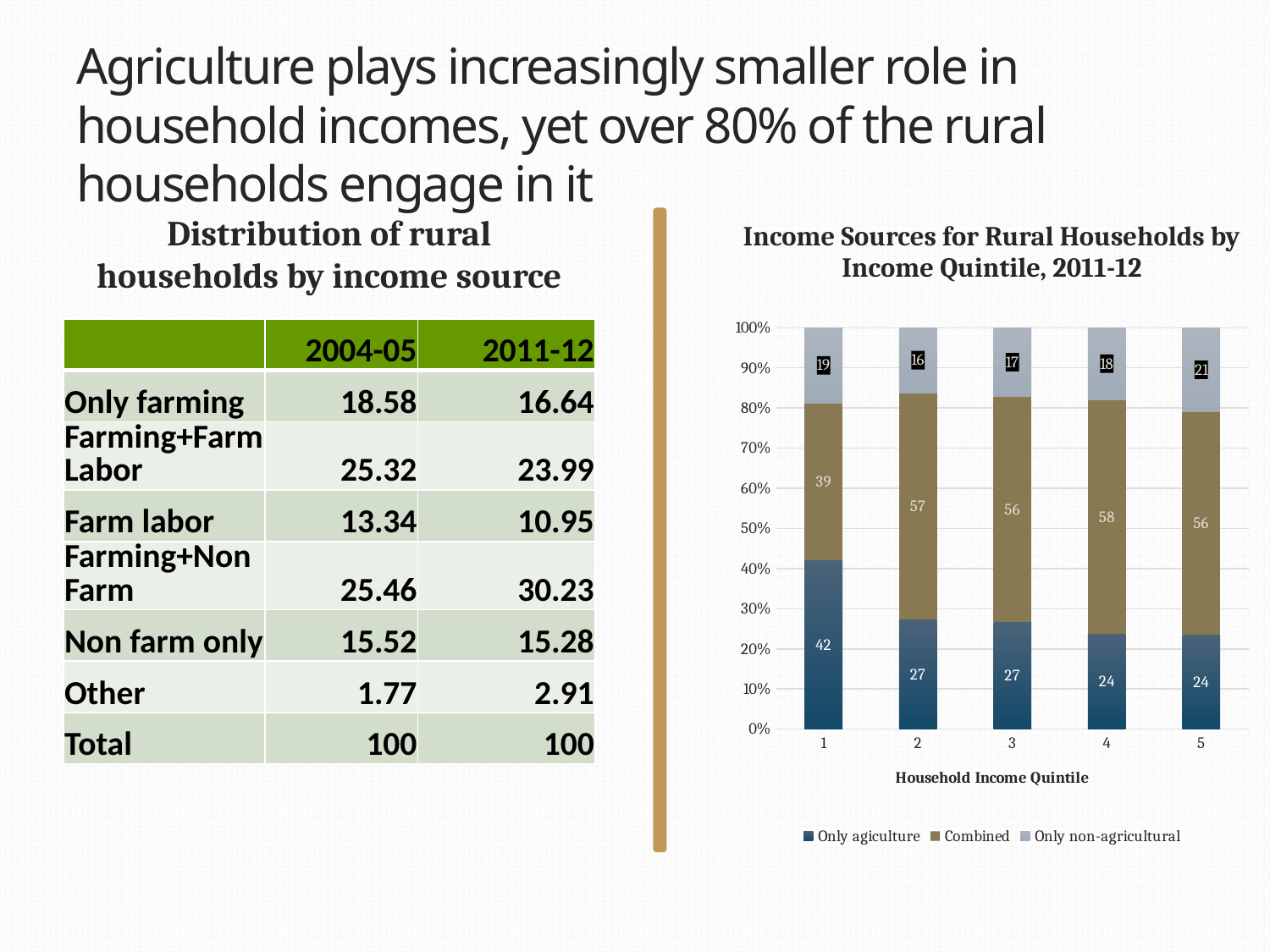
What is the title of the x axis of the chart? Household Income Quintile How many household income quintiles are shown on the x axis of the chart? 5 Does the Only agiculture value generally rise or fall from quintile 1 to quintile 5? Fall What is the value of the Only agiculture series for quintile 1? 42 Which quintile has the highest value for the Only agiculture series? 1 What is the difference between the Combined values for quintile 2 and quintile 1? 18 What is the value of the Only non-agricultural series for quintile 5? 21 Which quintile has the lowest value for the Combined series? 1 What type of chart is shown on the slide? Stacked bar chart How many series does the legend of the chart list? 3 Which is larger: the Only non-agricultural value for quintile 5 or for quintile 2? Quintile 5 What is the value of the Combined series for quintile 4? 58